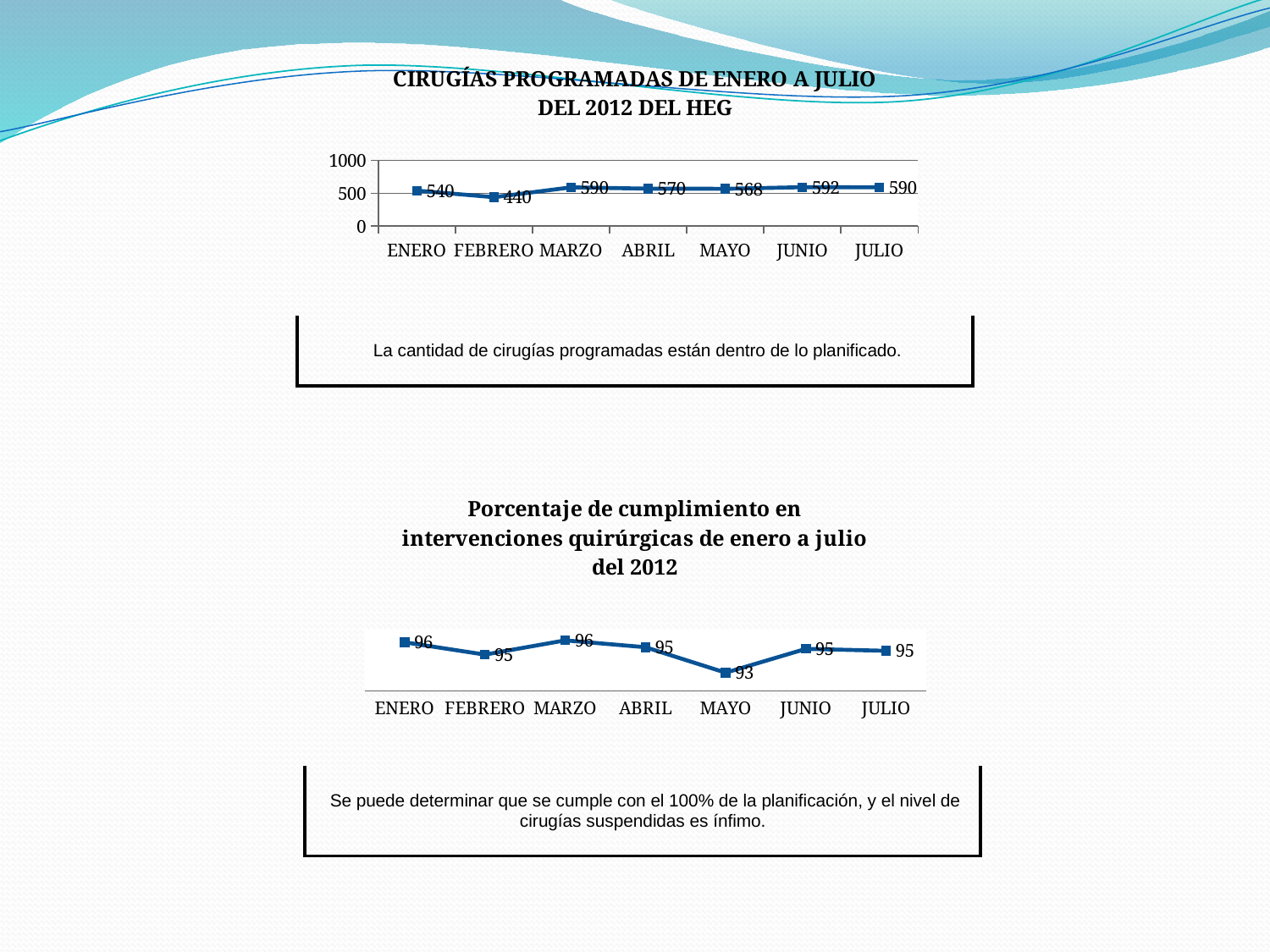
In the chart titled 'Porcentaje de cumplimiento en intervenciones quirúrgicas de enero a julio del 2012', which month has the lowest value? MAYO In the chart titled 'CIRUGÍAS PROGRAMADAS DE ENERO A JULIO DEL 2012 DEL HEG', how many months are plotted? 7 In the chart titled 'CIRUGÍAS PROGRAMADAS DE ENERO A JULIO DEL 2012 DEL HEG', what is the value for FEBRERO? 440 In the chart titled 'Porcentaje de cumplimiento en intervenciones quirúrgicas de enero a julio del 2012', which is larger, the value for MARZO or the value for MAYO? MARZO In the chart titled 'CIRUGÍAS PROGRAMADAS DE ENERO A JULIO DEL 2012 DEL HEG', which month has the lowest value? FEBRERO In the chart titled 'CIRUGÍAS PROGRAMADAS DE ENERO A JULIO DEL 2012 DEL HEG', does the value rise or fall from ENERO to FEBRERO? Fall In the chart titled 'Porcentaje de cumplimiento en intervenciones quirúrgicas de enero a julio del 2012', what is the value for MAYO? 93 In the chart titled 'CIRUGÍAS PROGRAMADAS DE ENERO A JULIO DEL 2012 DEL HEG', what is the value for JUNIO? 592 In the chart titled 'Porcentaje de cumplimiento en intervenciones quirúrgicas de enero a julio del 2012', what is the difference between the values for ENERO and MAYO? 3 In the chart titled 'CIRUGÍAS PROGRAMADAS DE ENERO A JULIO DEL 2012 DEL HEG', which month has the highest value? JUNIO In the chart titled 'CIRUGÍAS PROGRAMADAS DE ENERO A JULIO DEL 2012 DEL HEG', what is the difference between the values for MARZO and ENERO? 50 What kind of chart is the top chart on the slide? Line chart